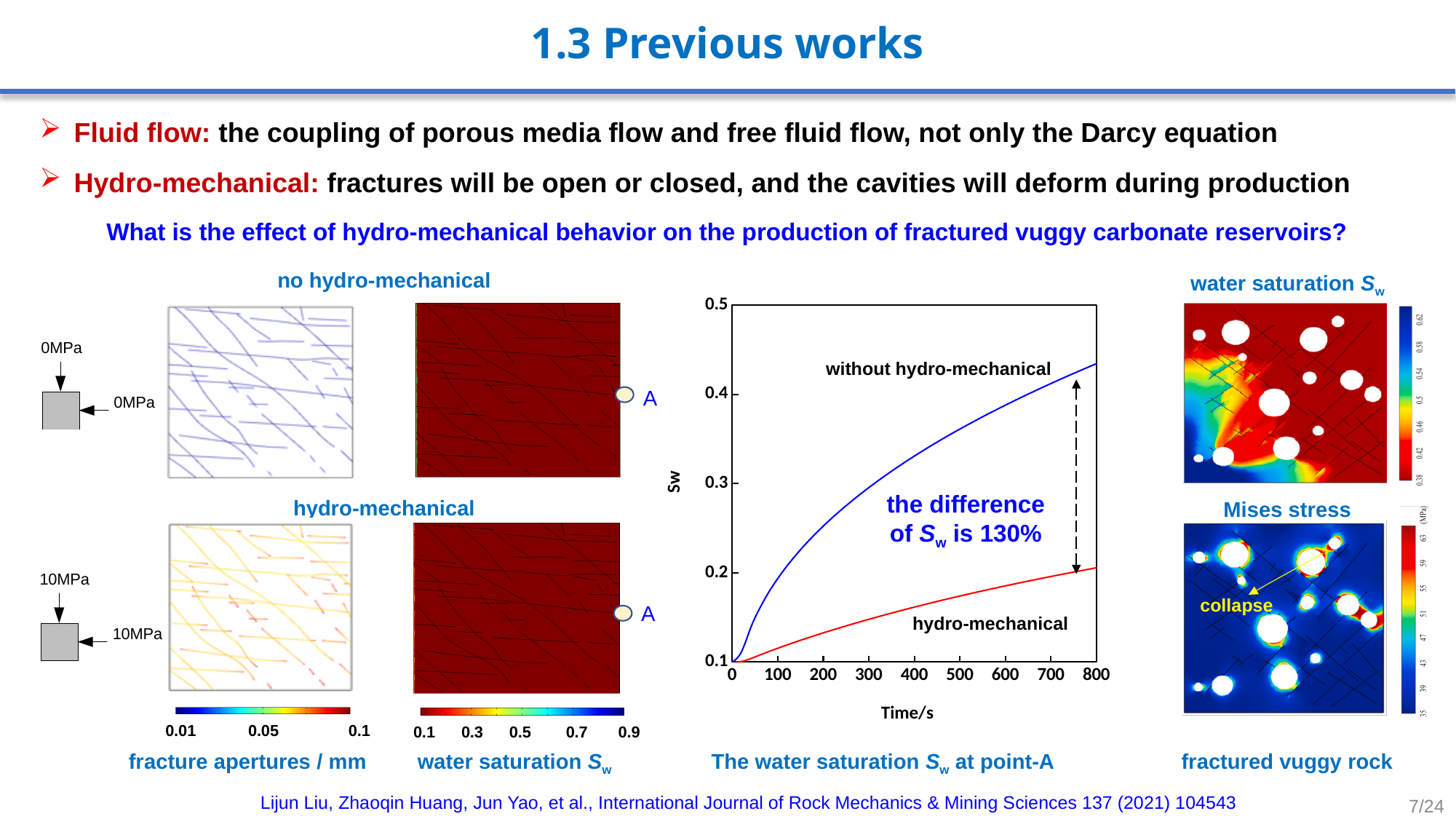
In the chart of water saturation Sw at point-A, is the 'without hydro-mechanical' value at 400 s greater or less than 0.3? greater In the chart of water saturation Sw at point-A, is the 'without hydro-mechanical' value at 800 s greater or less than 0.4? greater How many series are plotted in the chart of water saturation Sw at point-A? 2 In the chart of water saturation Sw at point-A, which series is drawn in red? hydro-mechanical In the chart of water saturation Sw at point-A, does Sw rise or fall with time for the 'hydro-mechanical' series? rise What kind of chart is 'The water saturation Sw at point-A'? line chart In the chart of water saturation Sw at point-A, what difference in Sw between the two curves does the annotation state? 130% In the chart of water saturation Sw at point-A, which series has the higher Sw at 800 s: 'without hydro-mechanical' or 'hydro-mechanical'? without hydro-mechanical In the chart of water saturation Sw at point-A, is the 'hydro-mechanical' value at 800 s greater or less than 0.3? less In the chart of water saturation Sw at point-A, what is the largest value shown on the Time/s axis? 800 In the chart of water saturation Sw at point-A, what is the label of the x axis? Time/s